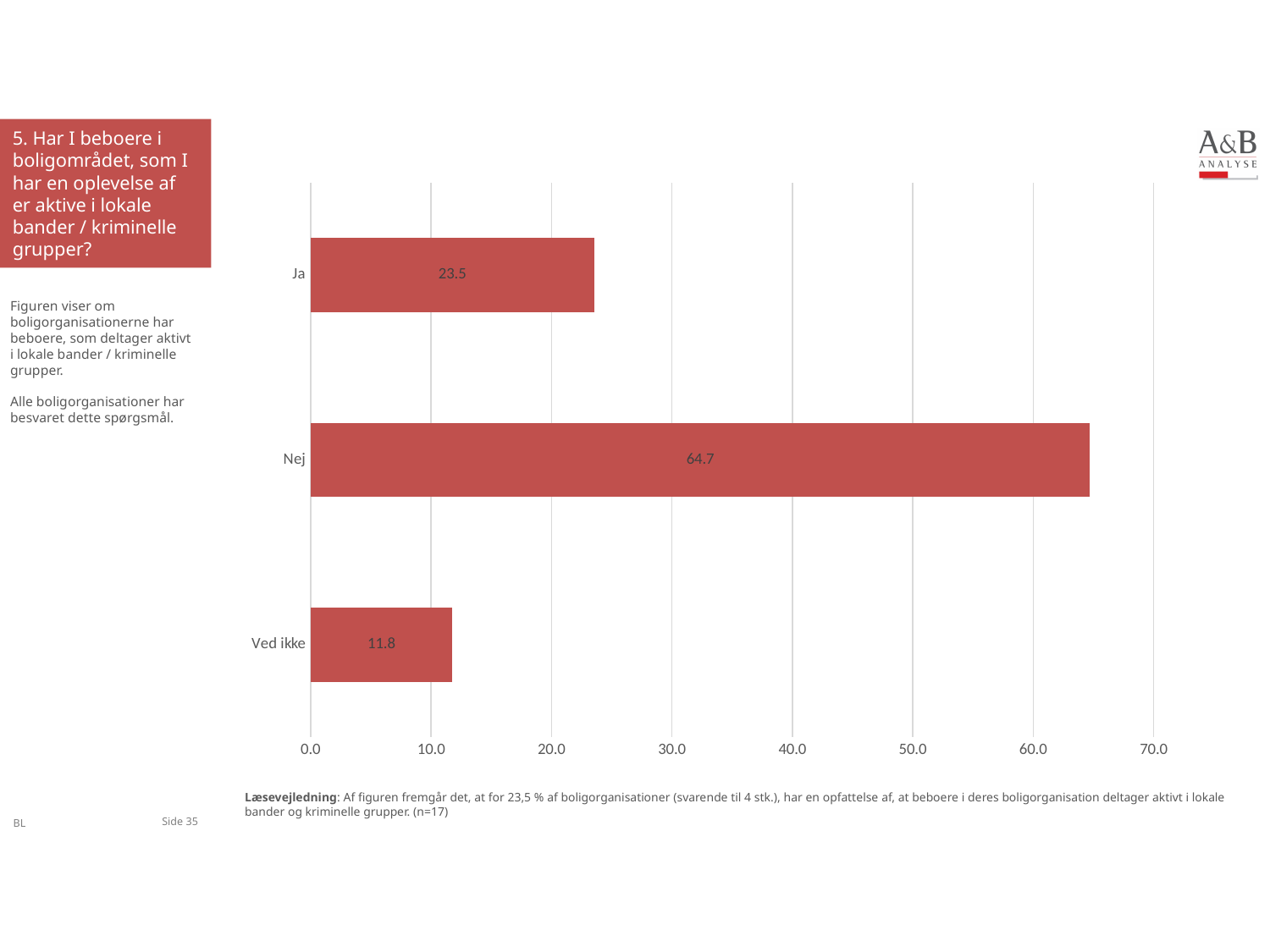
Which is larger, the value for Ja or the value for Ved ikke? Ja What is the value for Ved ikke? 11.8 What is the difference between the values for Ja and Ved ikke? 11.7 Which category has the highest value? Nej How many categories are shown in the chart? 3 What is the value for Ja? 23.5 What is the value for Nej? 64.7 What is the highest value shown on the x axis? 70.0 What is the difference between the values for Nej and Ja? 41.2 Which category has the lowest value? Ved ikke Is the value for Nej greater or less than 60.0? greater What kind of chart is shown on the slide? Bar chart